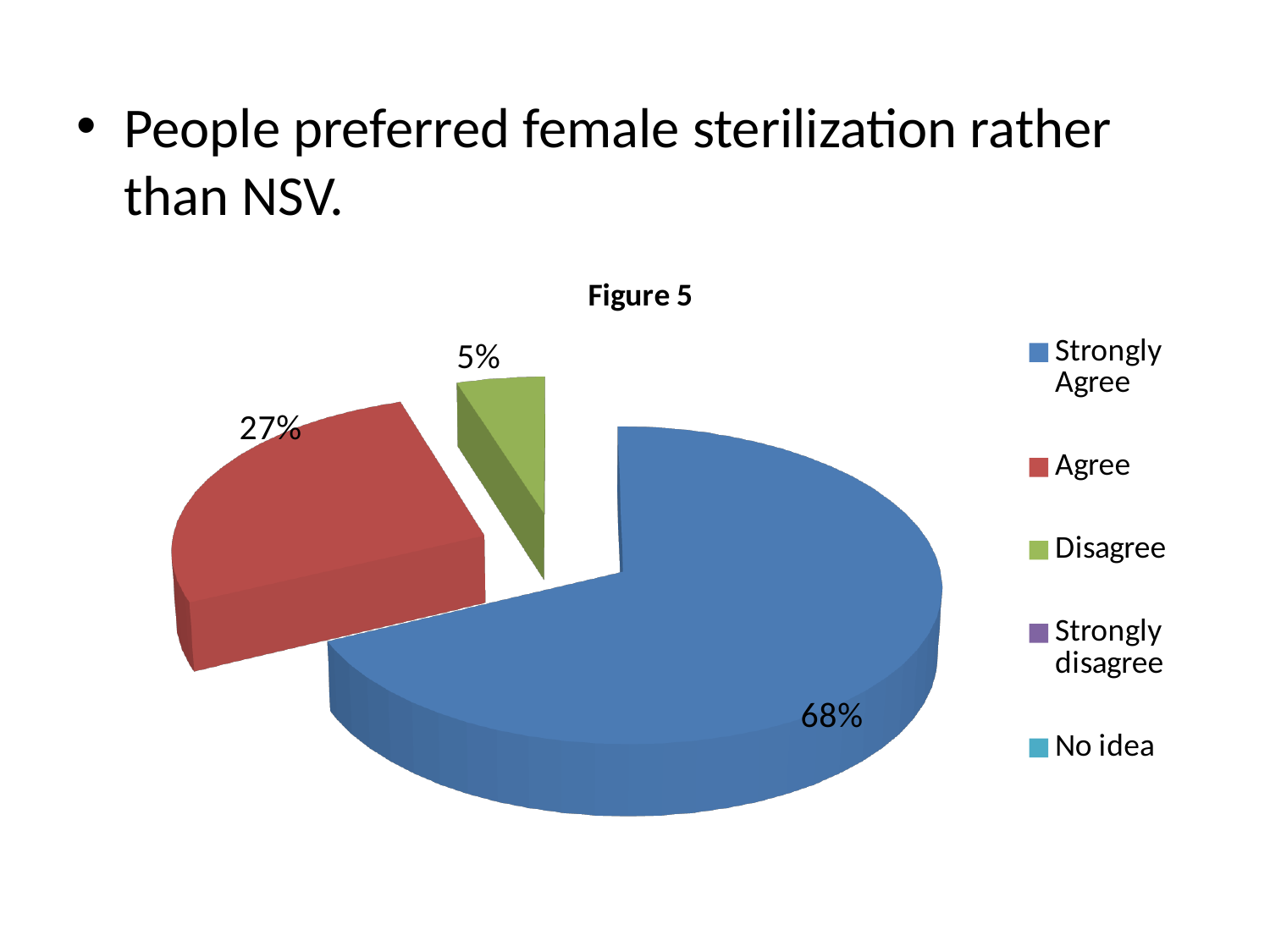
How many entries does the legend list? 5 What percentage of the pie is labelled for Disagree? 5% What percentage of the pie is labelled for Agree? 27% Of the three slices with printed labels, which is the smallest? Disagree What is the difference in percentage points between the Strongly Agree slice and the Agree slice? 41 What percentage of the pie is labelled for Strongly Agree? 68% Which category has the largest slice of the pie? Strongly Agree How many slices with printed percentage labels are visible in the pie? 3 What type of chart is shown in Figure 5? pie chart Which slice is larger, Agree or Disagree? Agree What colour is the Strongly Agree slice? blue What is the title of the chart? Figure 5